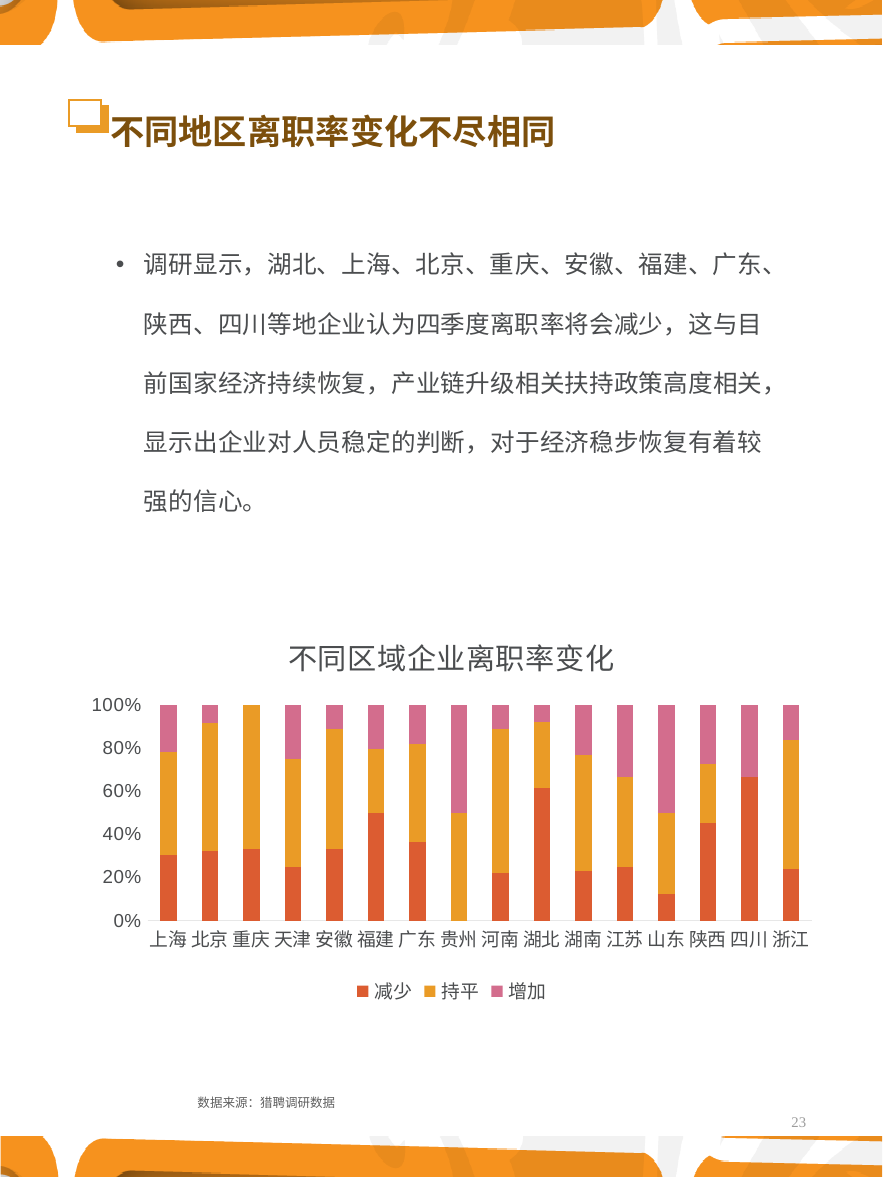
Which region has the larger 减少 share, 福建 or 北京? 福建 What is the title of the chart? 不同区域企业离职率变化 What are the three series listed in the chart legend? 减少, 持平, 增加 Is the 减少 share for 湖北 greater or less than 40%? greater What does each stacked bar in the chart total? 100% What kind of chart is shown on the slide? Stacked bar chart Is the 减少 share for 上海 greater or less than 40%? less Is the 减少 share for 山东 greater or less than 20%? less How many series does the chart legend list? 3 Which region has the larger 减少 share, 四川 or 上海? 四川 How many regions (categories) are shown on the x axis of the chart? 16